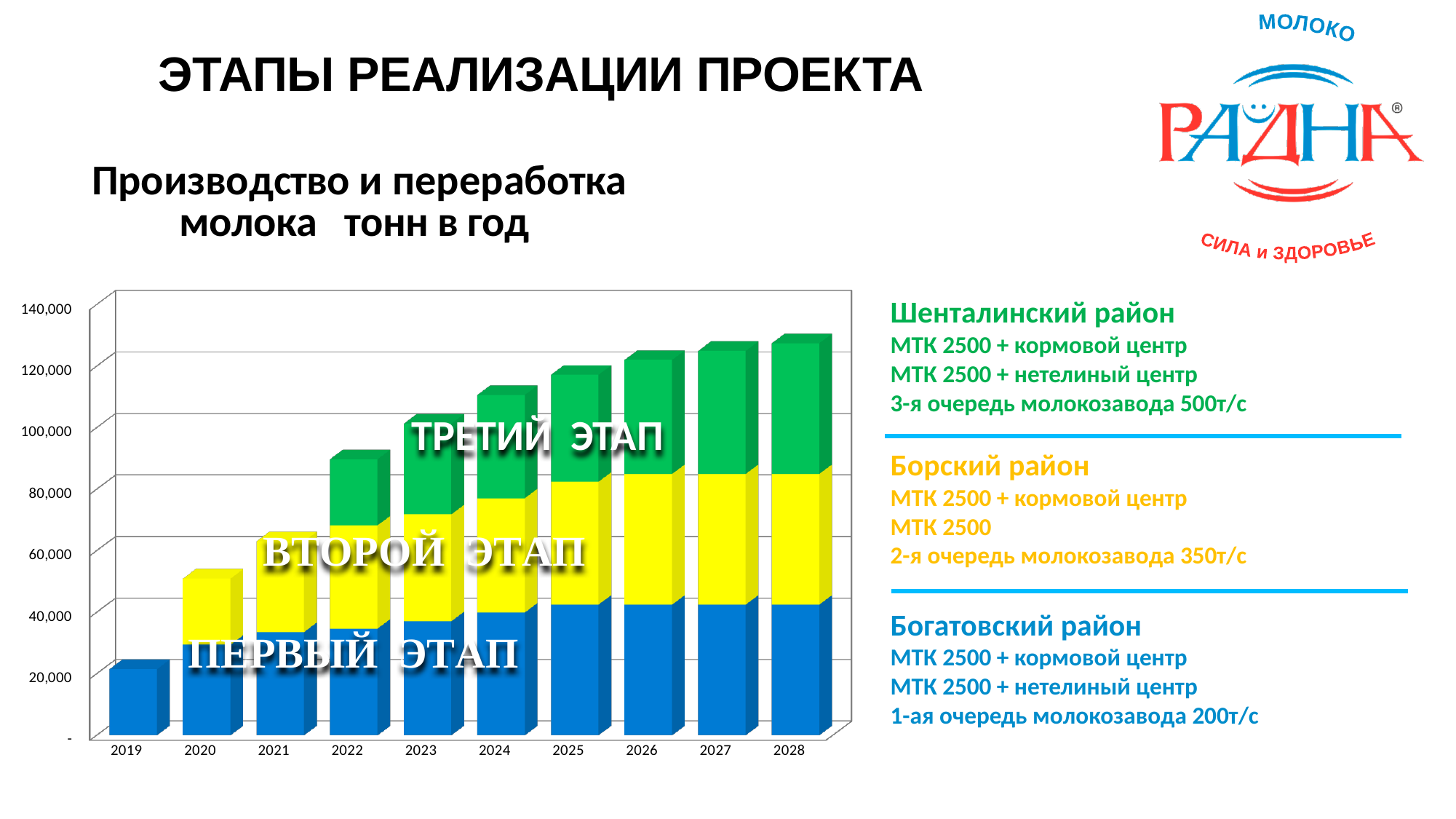
Do the total bar heights rise or fall from 2019 to 2028? Rise Is the total value for 2019 greater or less than 40,000? less Is the total value for 2021 greater or less than 80,000? less Which year has the larger total bar, 2021 or 2025? 2025 Is the total value for 2028 greater or less than 120,000? greater What kind of chart is shown on the slide? Stacked bar chart How many stages (этапы) are labelled on the chart? 3 How many years are shown on the x axis of the chart? 10 Which year has the lowest total bar in the chart? 2019 Which year has the highest total bar in the chart? 2028